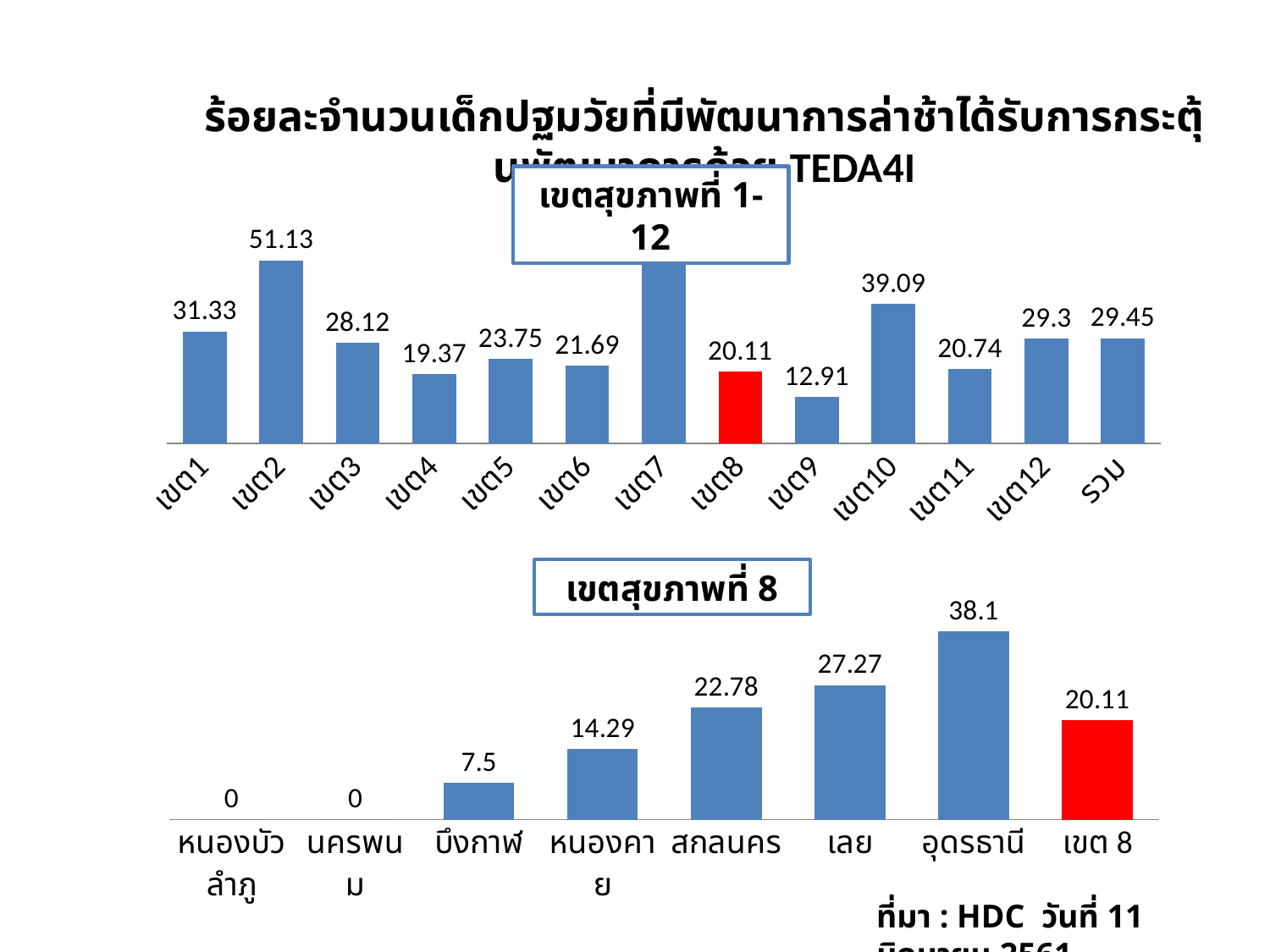
In the top chart (เขตสุขภาพที่ 1-12), which bar is coloured red? เขต8 In the top chart (เขตสุขภาพที่ 1-12), which category has the lowest value? เขต9 In the bottom chart (เขตสุขภาพที่ 8), what is the value for อุดรธานี? 38.1 In the bottom chart (เขตสุขภาพที่ 8), what is the difference between the values for อุดรธานี and เลย? 10.83 In the top chart (เขตสุขภาพที่ 1-12), which is larger, the value for เขต10 or the value for เขต12? เขต10 In the top chart (เขตสุขภาพที่ 1-12), how many categories are shown on the x axis? 13 In the top chart (เขตสุขภาพที่ 1-12), what is the value for รวม? 29.45 In the top chart (เขตสุขภาพที่ 1-12), what is the difference between the values for เขต2 and เขต1? 19.8 In the top chart (เขตสุขภาพที่ 1-12), what is the value for เขต2? 51.13 What kind of chart is the bottom chart (เขตสุขภาพที่ 8)? bar chart In the bottom chart (เขตสุขภาพที่ 8), how many categories are shown on the x axis? 8 In the bottom chart (เขตสุขภาพที่ 8), which category has the highest value? อุดรธานี